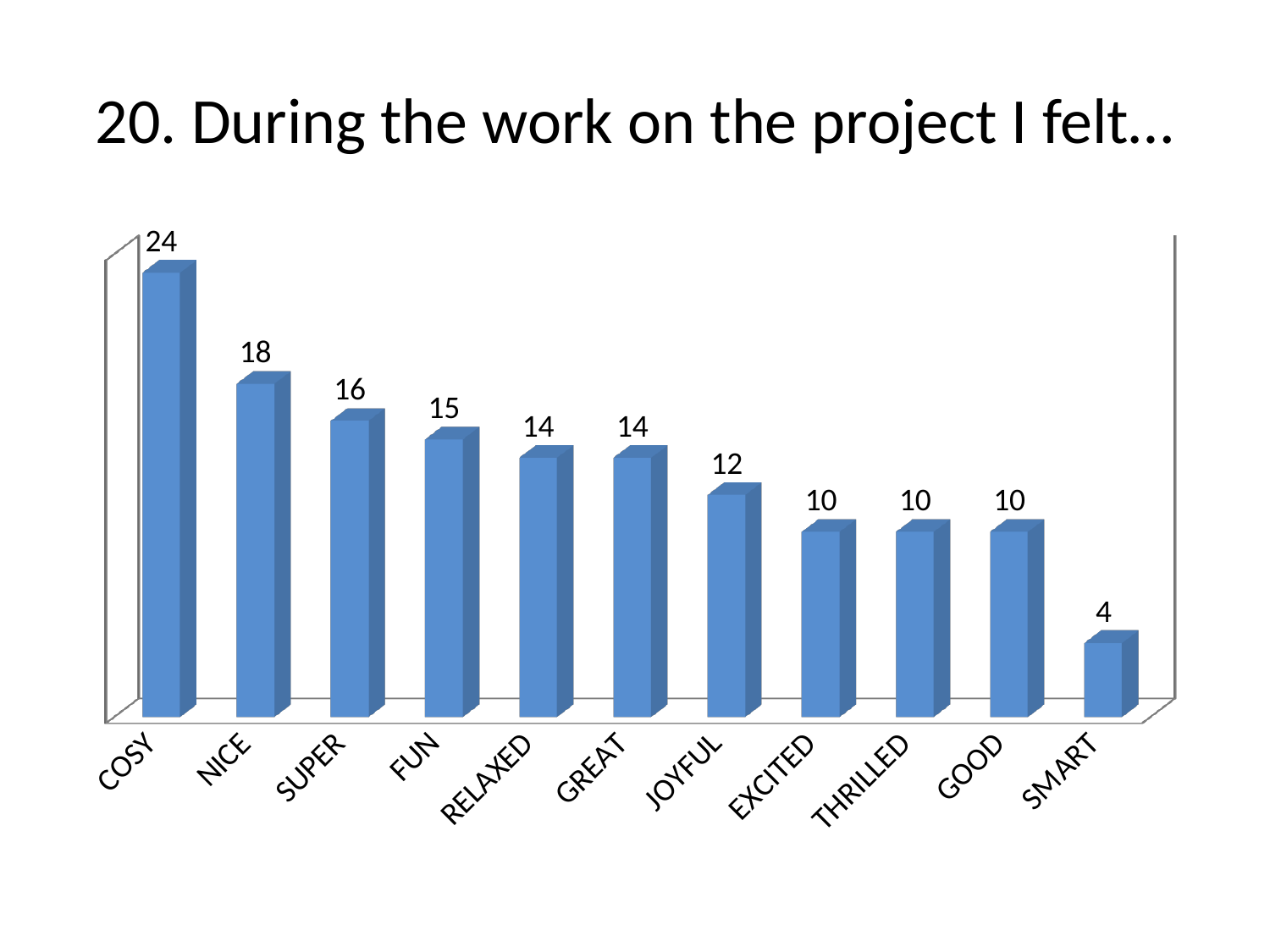
What kind of chart is shown on the slide? bar chart What is the value for COSY? 24 What is the difference between the values for FUN and SMART? 11 What is the value for SMART? 4 Which category has the lowest value? SMART What is the value for SUPER? 16 Do the values rise or fall from left to right along the x axis? fall What is the difference between the values for COSY and NICE? 6 How many categories are shown in the chart? 11 Which category has the highest value? COSY What is the value for JOYFUL? 12 Which is larger, the value for NICE or the value for GREAT? NICE